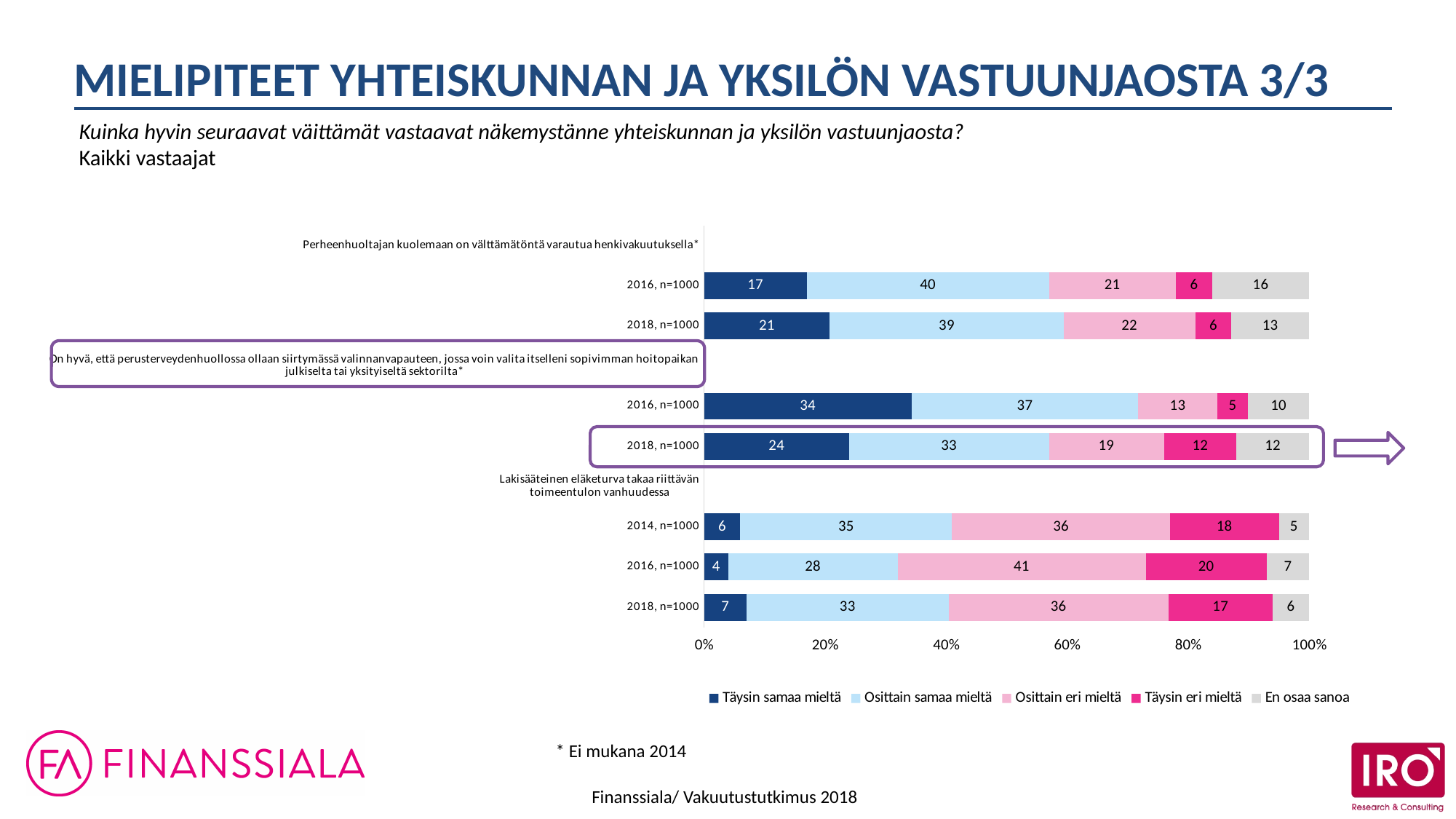
Which bar has the highest 'Täysin samaa mieltä' value? 2016, n=1000 under 'On hyvä, että perusterveydenhuollossa ollaan siirtymässä valinnanvapauteen...' Which legend entry is shown in grey? En osaa sanoa How many series does the legend list? 5 What is the combined 'Täysin samaa mieltä' and 'Osittain samaa mieltä' value for the 2018 bar under 'Lakisääteinen eläketurva takaa riittävän toimeentulon vanhuudessa'? 40 What is the 'Osittain eri mieltä' value for the 2016 bar under 'Lakisääteinen eläketurva takaa riittävän toimeentulon vanhuudessa'? 41 How much did the 'Täysin samaa mieltä' value for 'On hyvä, että perusterveydenhuollossa...' fall from 2016 to 2018? 10 What is the 'Täysin eri mieltä' value for the 2018 bar under 'On hyvä, että perusterveydenhuollossa ollaan siirtymässä valinnanvapauteen...'? 12 What kind of chart is shown on the slide? Stacked bar chart For 'Lakisääteinen eläketurva takaa riittävän toimeentulon vanhuudessa', is the 'Täysin eri mieltä' value larger in 2014 or 2016? 2016 Which bar has the lowest 'Täysin samaa mieltä' value? 2016, n=1000 under 'Lakisääteinen eläketurva takaa riittävän toimeentulon vanhuudessa' What is the 'Täysin samaa mieltä' value for the 2018 bar under 'Perheenhuoltajan kuolemaan on välttämätöntä varautua henkivakuutuksella'? 21 How many bars are plotted in the chart? 7